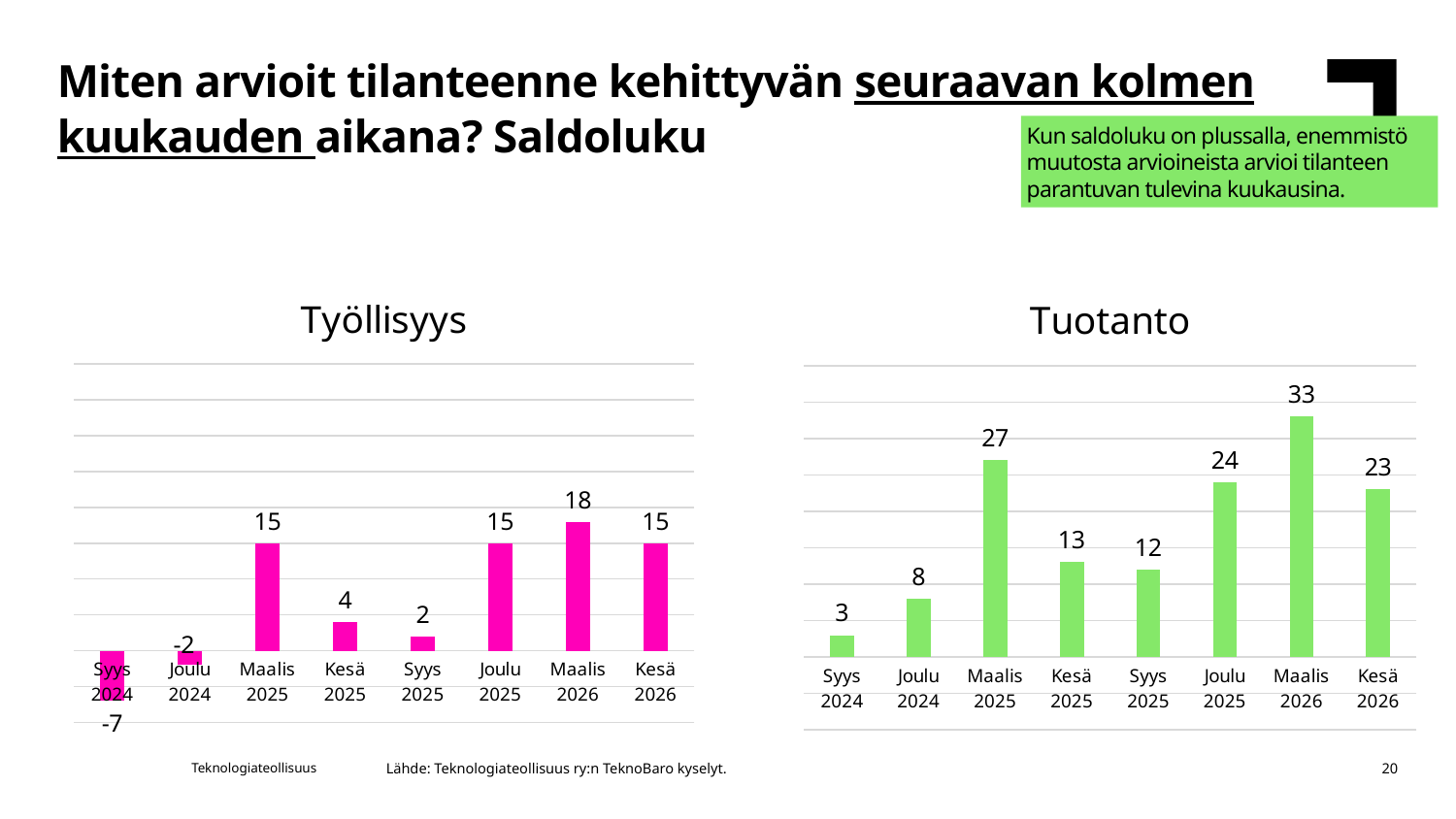
What colour are the bars in the Tuotanto chart? Green In the Työllisyys chart, what is the value for Maalis 2026? 18 In the Tuotanto chart, which is larger, the value for Kesä 2025 or the value for Syys 2025? Kesä 2025 In the Tuotanto chart, which category has the highest value? Maalis 2026 In the Tuotanto chart, what is the difference between the values for Maalis 2026 and Kesä 2026? 10 What type of chart is the Työllisyys chart? Bar chart In the Työllisyys chart, what is the difference between the values for Maalis 2025 and Kesä 2025? 11 How many categories are shown in the Tuotanto chart? 8 In the Työllisyys chart, which category has the lowest value? Syys 2024 In the Tuotanto chart, what is the value for Joulu 2025? 24 In the Tuotanto chart, which category has the lowest value? Syys 2024 In the Työllisyys chart, what is the value for Syys 2024? -7